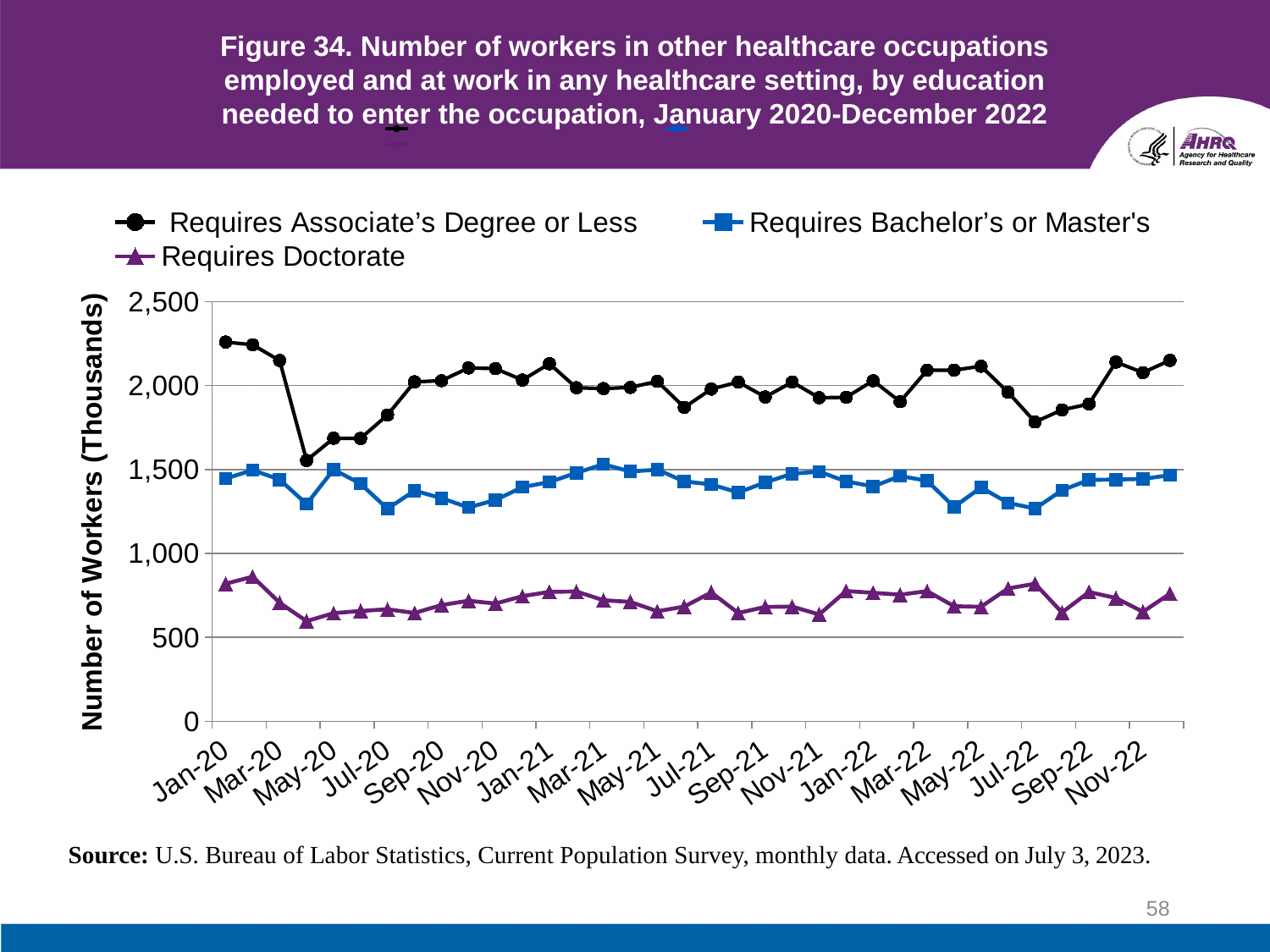
What is the label on the y axis? Number of Workers (Thousands) In Jan-20, which is larger: the value for Requires Associate's Degree or Less or the value for Requires Doctorate? Requires Associate's Degree or Less Does the Requires Associate's Degree or Less series rise or fall between Jan-20 and Apr-20? Fall Is the value for Requires Doctorate in Jan-20 greater or less than 500? greater Which series has the highest values throughout the chart? Requires Associate's Degree or Less Is the value for Requires Doctorate in Jan-20 greater or less than 1,000? less Which series has the lowest values throughout the chart? Requires Doctorate Is the value for Requires Associate's Degree or Less in Jan-20 greater or less than 2,000? greater How many month labels are shown along the x axis? 18 What kind of chart is shown on the slide? Line chart How many series does the legend list? 3